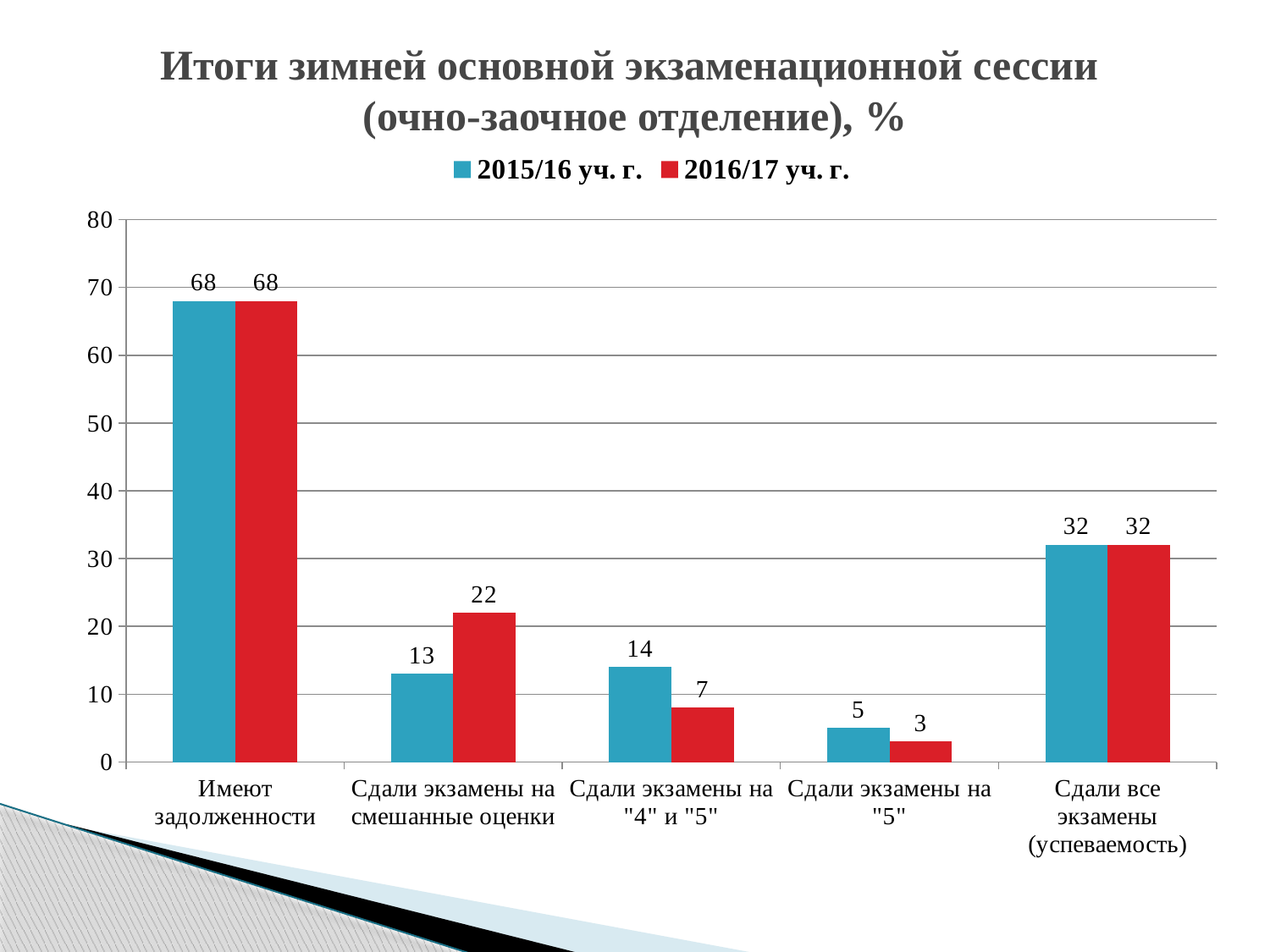
What is the value for "Сдали экзамены на "4" и "5"" in the 2015/16 уч. г. series? 14 What is the value for "Сдали все экзамены (успеваемость)" in the 2015/16 уч. г. series? 32 Which series has the larger value for "Сдали экзамены на "4" и "5""? 2015/16 уч. г. Which category has the lowest value in the 2016/17 уч. г. series? Сдали экзамены на "5" Which colour represents the 2016/17 уч. г. series? Red How many series does the legend list? 2 What kind of chart is shown on the slide? Bar chart How many categories are shown on the x axis? 5 What is the difference between the 2016/17 уч. г. and 2015/16 уч. г. values for "Сдали экзамены на смешанные оценки"? 9 Which category has the highest value in the 2015/16 уч. г. series? Имеют задолженности What is the value for "Сдали экзамены на смешанные оценки" in the 2016/17 уч. г. series? 22 What is the value for "Сдали экзамены на "5"" in the 2016/17 уч. г. series? 3